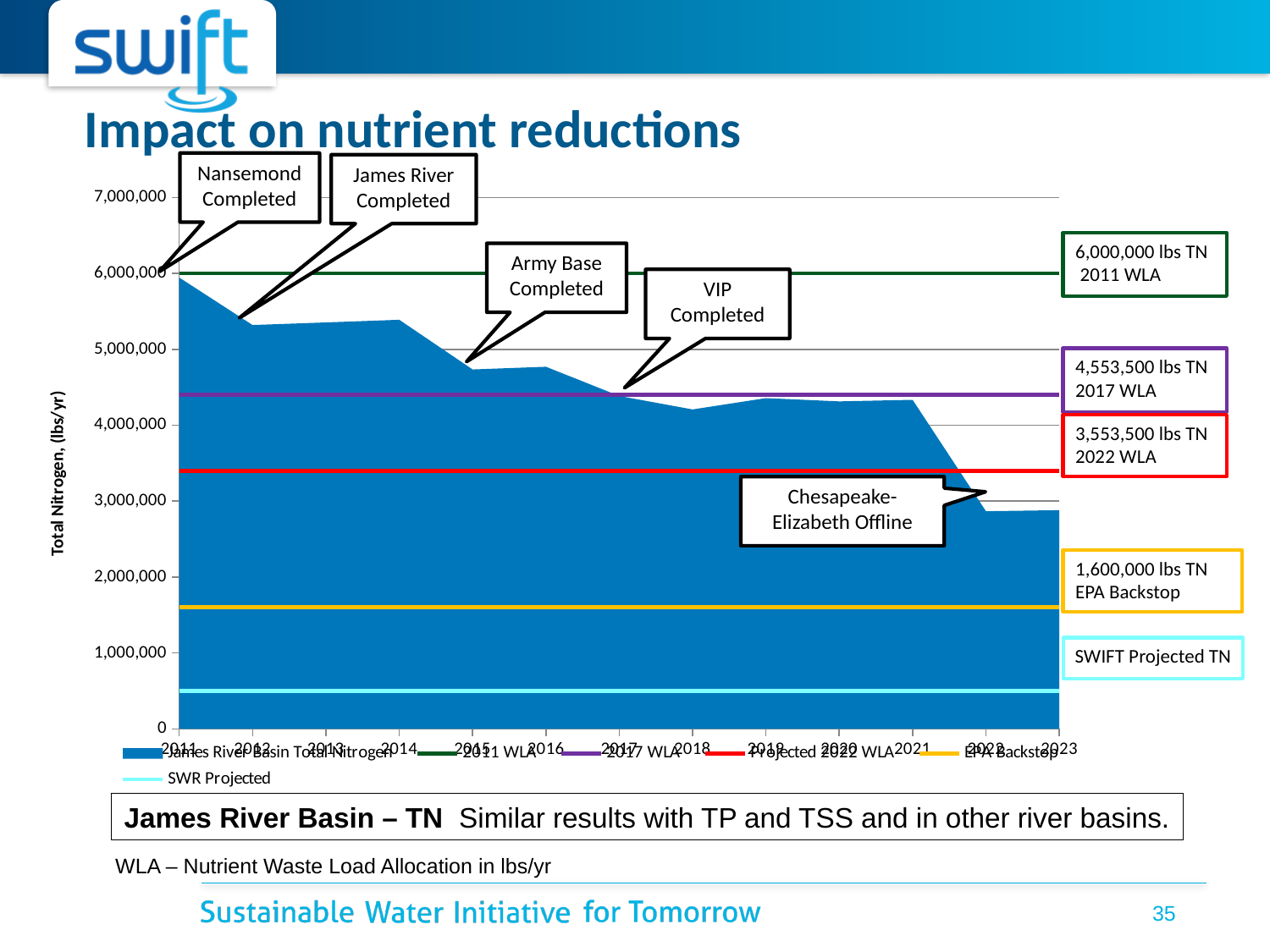
What is the value of the 2011 WLA line, as labelled on the slide? 6,000,000 lbs TN How many series does the chart legend list? 6 What is the difference between the 2017 WLA and the 2022 WLA values? 1,000,000 lbs TN Does the James River Basin Total Nitrogen generally rise or fall from 2011 to 2023? Fall Is the James River Basin Total Nitrogen value for 2011 greater or less than 5,000,000? greater What is the value of the 2022 WLA line, as labelled on the slide? 3,553,500 lbs TN What is the value of the EPA Backstop line, as labelled on the slide? 1,600,000 lbs TN What is the value of the 2017 WLA line, as labelled on the slide? 4,553,500 lbs TN What kind of chart is shown on the slide? Combination area and line chart How many years are shown along the x axis of the chart? 13 In which year is the James River Basin Total Nitrogen highest? 2011 Is the James River Basin Total Nitrogen value for 2023 greater or less than 3,000,000? less